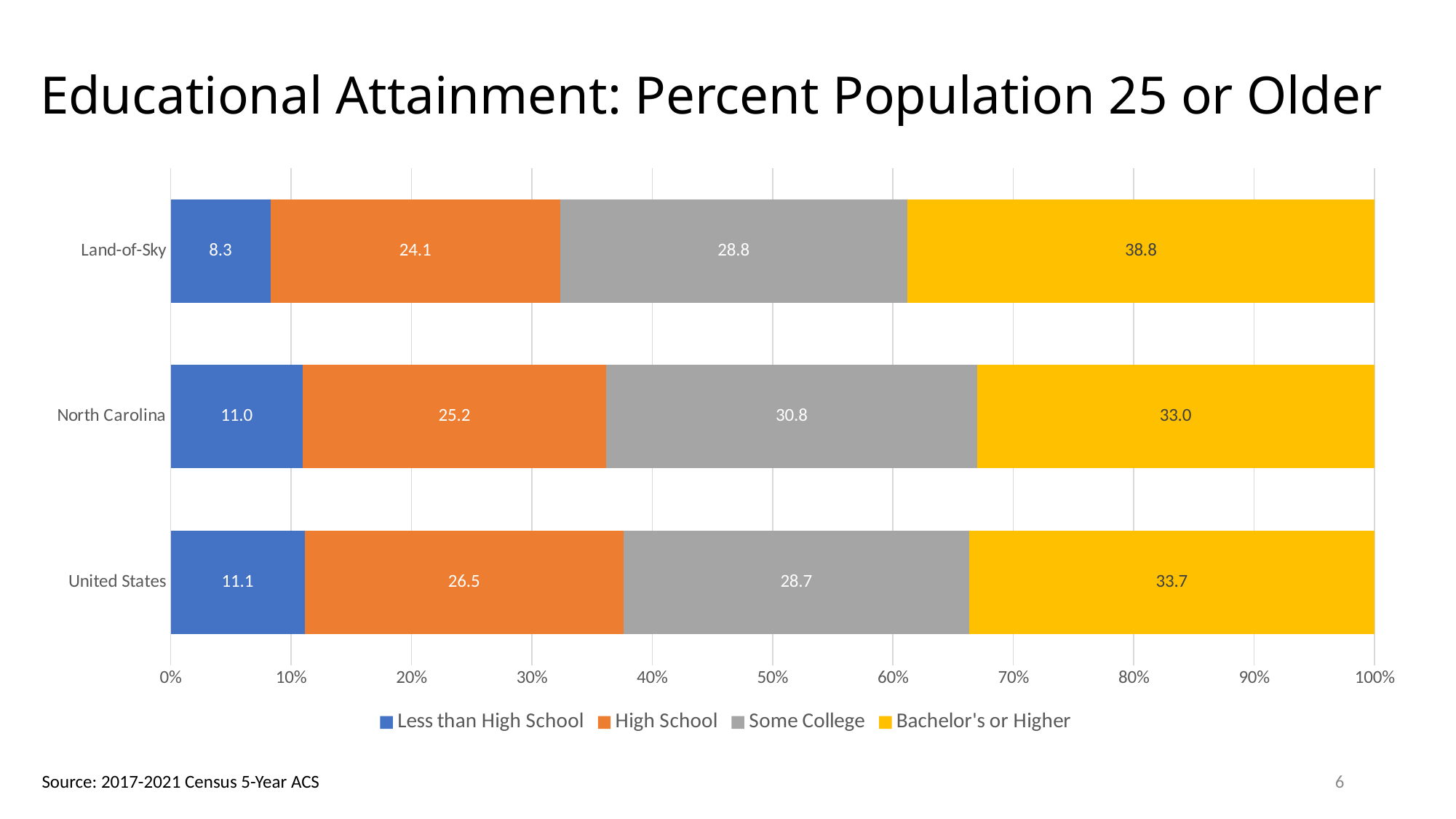
What is the value for Less than High School for United States? 11.1 What is the value for Bachelor's or Higher for Land-of-Sky? 38.8 Which is larger, the High School value for United States or for Land-of-Sky? United States What is the difference between the Some College values for North Carolina and Land-of-Sky? 2.0 What is the value for High School for North Carolina? 25.2 What kind of chart is shown on the slide? Stacked bar chart How many series does the legend list? 4 Which region has the lowest value for Less than High School? Land-of-Sky What is the total of the stacked bar for North Carolina? 100.0 Which region has the highest value for Bachelor's or Higher? Land-of-Sky How many regions are shown on the chart? 3 What colour represents Some College in the chart? Gray